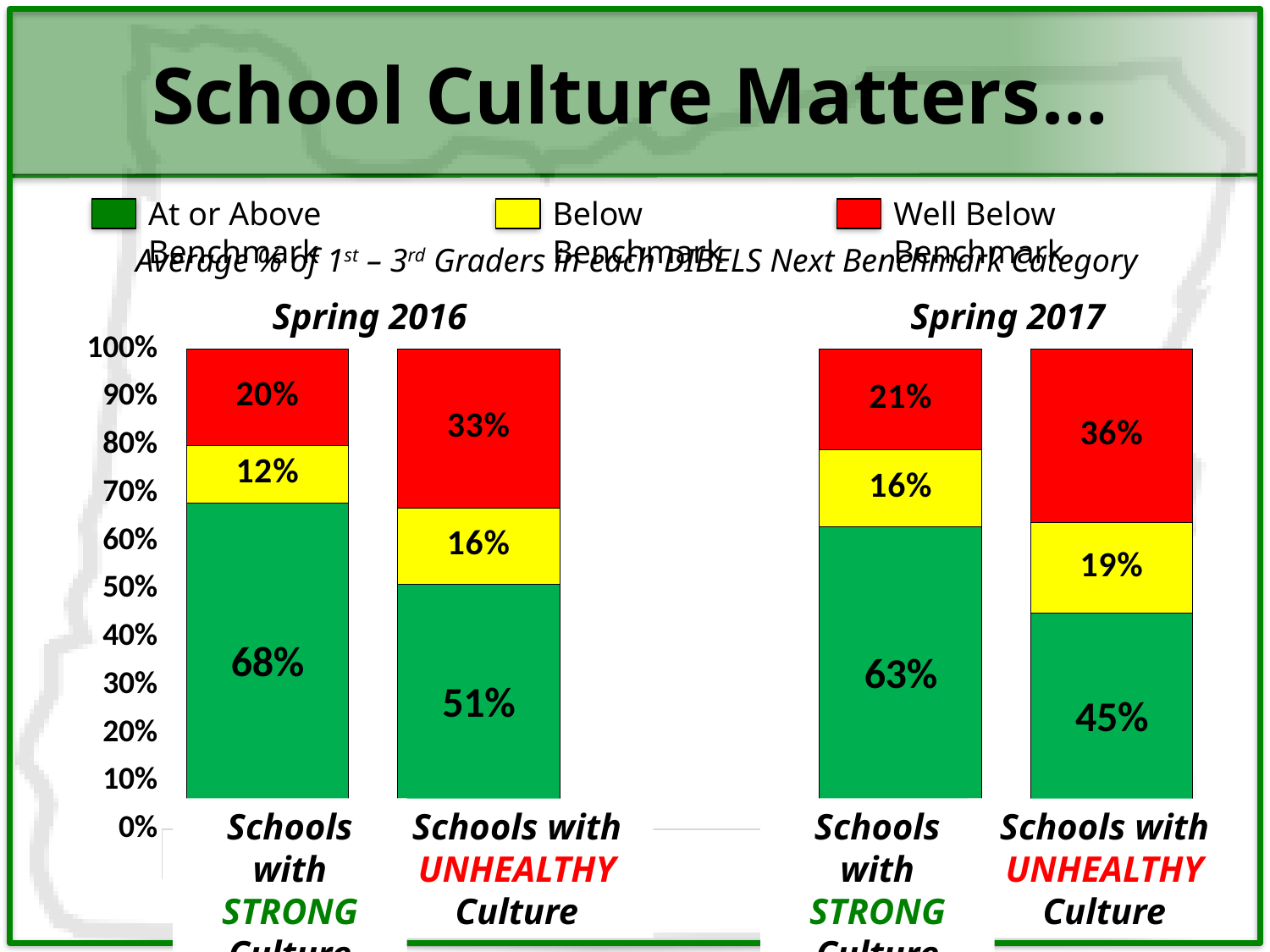
Which colour represents Well Below Benchmark in the legend? Red In the Spring 2016 chart, what is the difference in the At or Above Benchmark percentage between schools with STRONG culture and schools with UNHEALTHY culture? 17% How many series does the legend list? 3 In the Spring 2017 chart, what percentage of students in schools with UNHEALTHY culture are At or Above Benchmark? 45% In the Spring 2017 chart, which category has the larger At or Above Benchmark percentage, schools with STRONG culture or schools with UNHEALTHY culture? Schools with STRONG Culture What kind of chart is the Spring 2016 chart? Stacked bar chart In the Spring 2016 chart, which category has the higher Well Below Benchmark percentage? Schools with UNHEALTHY Culture In the Spring 2016 chart, what percentage of students in schools with UNHEALTHY culture are Well Below Benchmark? 33% In the Spring 2017 chart, what percentage of students in schools with STRONG culture are Below Benchmark? 16% In the Spring 2016 chart, what percentage of students in schools with STRONG culture are At or Above Benchmark? 68% How many categories are shown in the Spring 2017 chart? 2 In the Spring 2017 chart, what is the difference in the Well Below Benchmark percentage between schools with UNHEALTHY culture and schools with STRONG culture? 15%